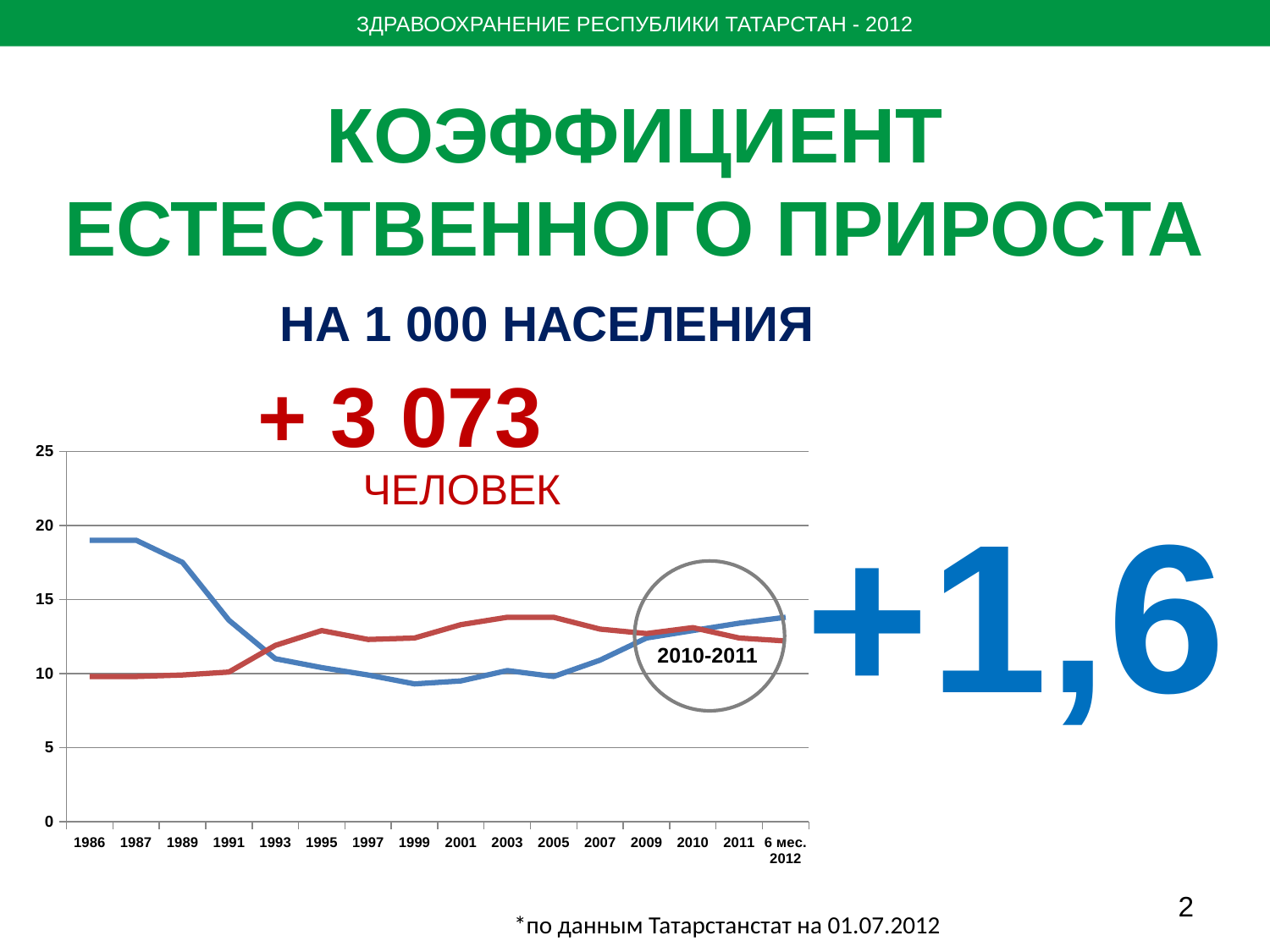
What kind of chart is shown on the slide? line chart How many categories are shown on the x axis of the chart? 16 Does the blue line rise or fall from 1986 to 1999? fall Is the value of the red line for 2003 greater or less than 10? greater What label is written inside the circle drawn on the chart? 2010-2011 Is the value of the red line for 1995 greater or less than 15? less Which line has the higher value in 2003, the blue line or the red line? the red line Is the value of the blue line for 1989 greater or less than 15? greater Which line has the higher value in 1986, the blue line or the red line? the blue line